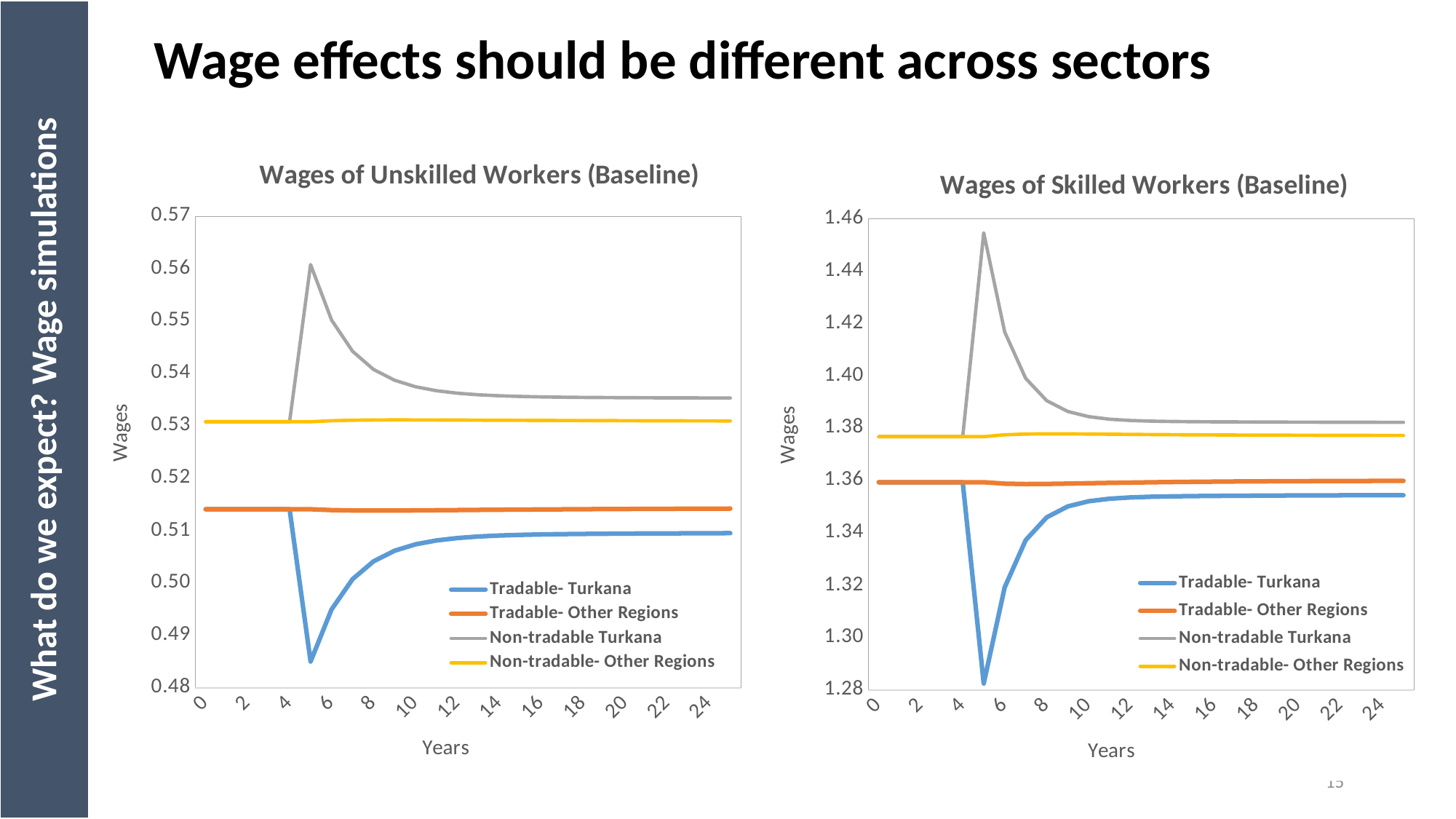
What kind of chart is the 'Wages of Unskilled Workers (Baseline)' chart? line chart In the 'Wages of Skilled Workers (Baseline)' chart, is the lowest value of Tradable- Turkana greater or less than 1.30? less In the 'Wages of Unskilled Workers (Baseline)' chart, does the Non-tradable Turkana series rise or fall between year 6 and year 24? fall In the 'Wages of Skilled Workers (Baseline)' chart, does the Tradable- Turkana series rise or fall between year 6 and year 24? rise In the 'Wages of Skilled Workers (Baseline)' chart, which series reaches the lowest value? Tradable- Turkana In the 'Wages of Unskilled Workers (Baseline)' chart, is the lowest value of Tradable- Turkana greater or less than 0.49? less In the 'Wages of Skilled Workers (Baseline)' chart, is the peak value of Non-tradable Turkana greater or less than 1.44? greater How many series does the legend of the 'Wages of Skilled Workers (Baseline)' chart list? 4 In the 'Wages of Unskilled Workers (Baseline)' chart, which series is higher throughout: Non-tradable- Other Regions or Tradable- Other Regions? Non-tradable- Other Regions In the 'Wages of Unskilled Workers (Baseline)' chart, which series reaches the highest value? Non-tradable Turkana What is the x-axis label of the 'Wages of Skilled Workers (Baseline)' chart? Years